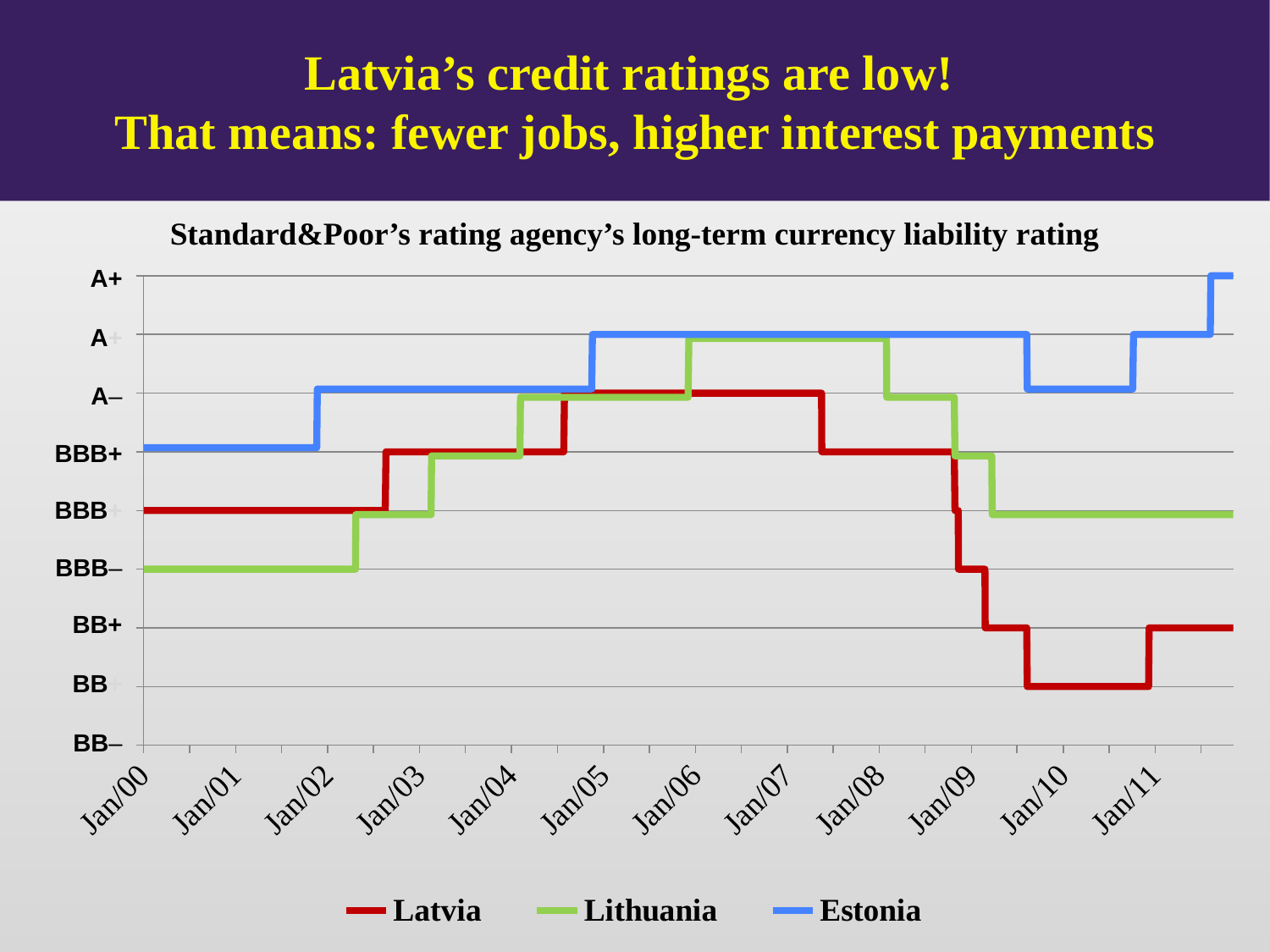
What was Lithuania's rating at Jan/11? BBB What was Estonia's rating at Jan/00? BBB+ At Jan/10, which country had the higher rating, Estonia or Latvia? Estonia Which colour represents Latvia in the chart? red What was Lithuania's rating at Jan/00? BBB– What is the highest rating Latvia reaches on the chart? A– What was Latvia's rating at Jan/00? BBB What is Estonia's rating at the right end of the chart? A+ What is the lowest rating Latvia reaches on the chart? BB How many series does the legend list? 3 What was Latvia's rating at Jan/10? BB What kind of chart is shown on the slide? line chart